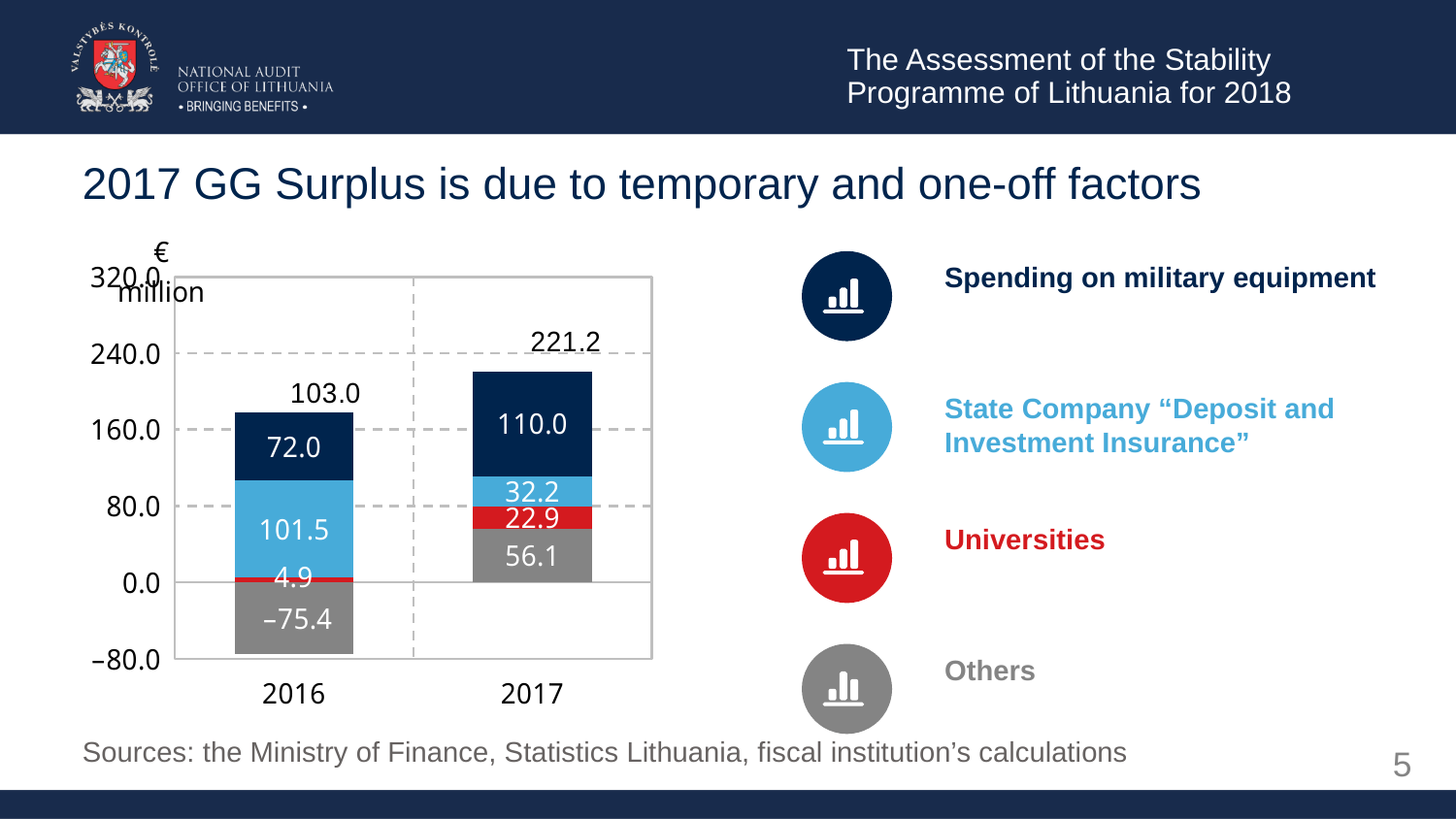
What is the difference between the 2017 total (221.2) and the 2016 total (103.0)? 118.2 How many years (categories) are shown on the x axis of the chart? 2 Which is larger: Spending on military equipment in 2016 or in 2017? 2017 How many series does the legend on the right of the chart list? 4 What is the value for Universities in 2017? 22.9 What unit is shown on the y axis of the chart? € million What is the value for Others in 2016? –75.4 What is the value for State Company "Deposit and Investment Insurance" in 2016? 101.5 What is the total of the stacked bar for 2016? 103.0 What is the value for Spending on military equipment in 2017? 110.0 What is the total of the stacked bar for 2017? 221.2 What kind of chart is shown on the slide? stacked bar chart